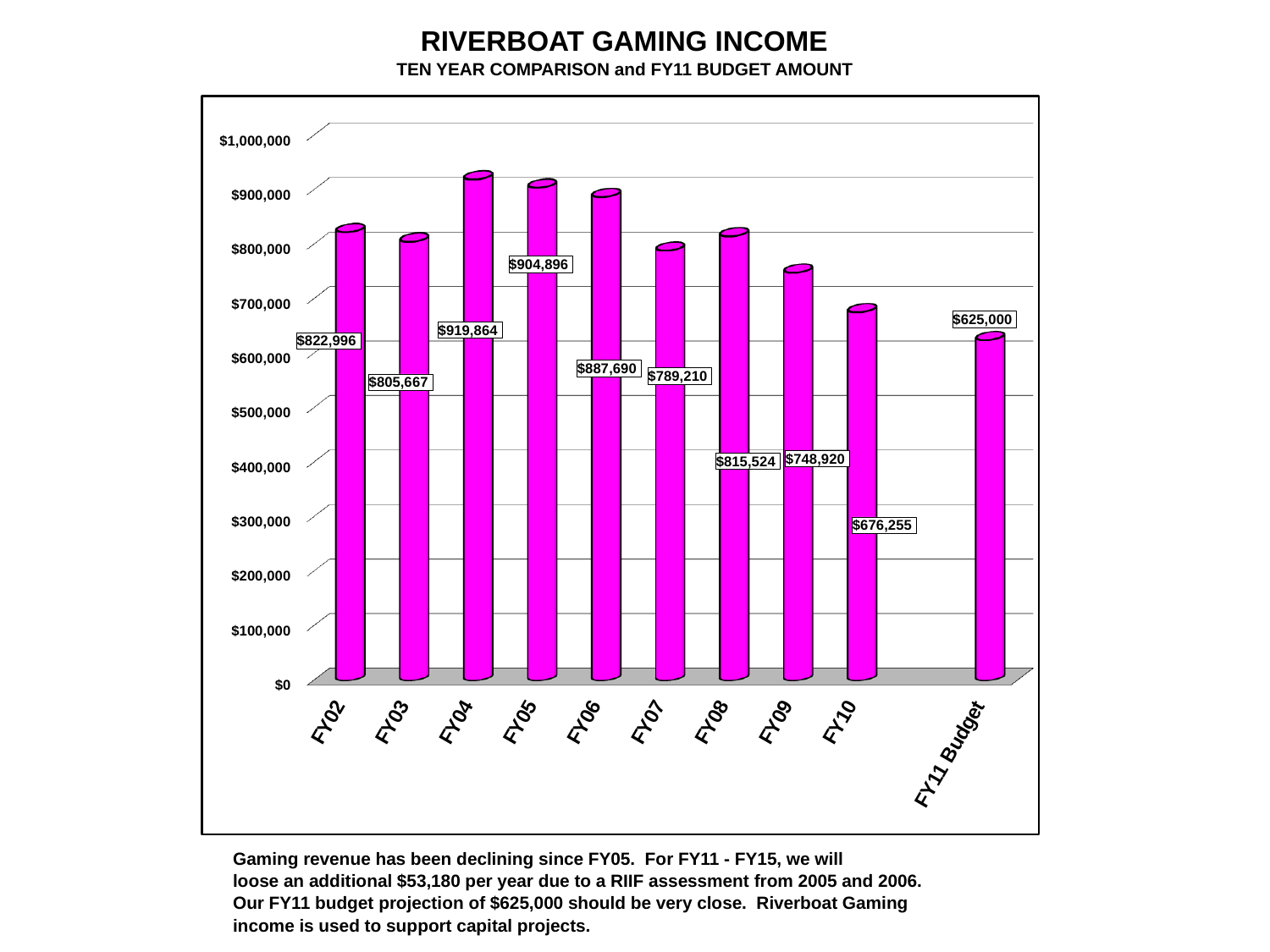
What is the difference between the FY04 and FY05 values? $14,968 Which category has the highest value? FY04 Which is larger, the value for FY02 or the value for FY08? FY02 Which category has the lowest value? FY11 Budget Do the values rise or fall from FY05 to FY11 Budget? Fall What is the FY11 Budget amount? $625,000 What is the difference between the FY10 value and the FY11 Budget amount? $51,255 How many bars are plotted on the chart? 10 What is the value for FY04? $919,864 What kind of chart is shown? Bar chart What is the value for FY10? $676,255 Is the value for FY09 greater or less than $700,000? greater